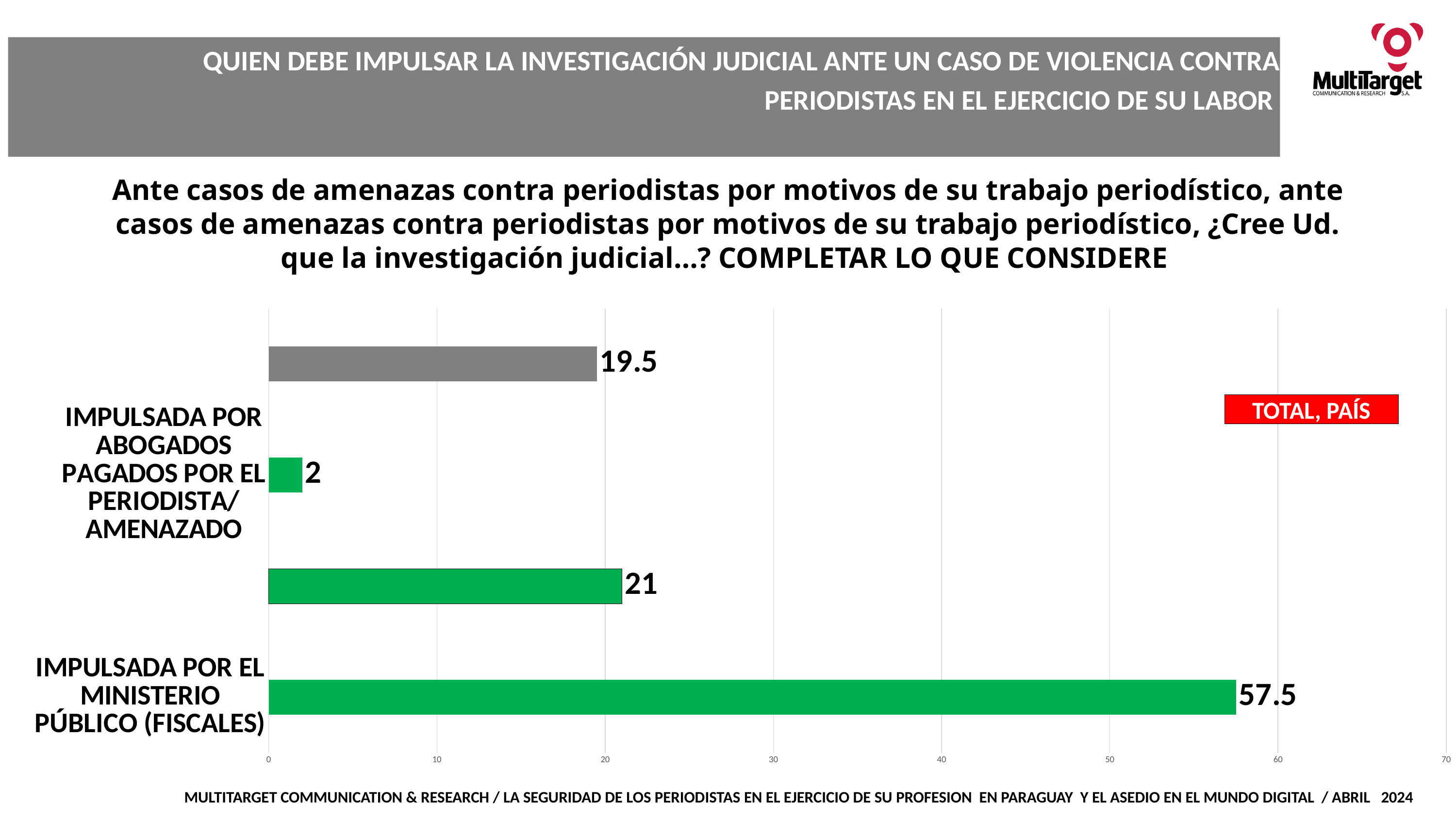
What value is shown for IMPULSADA POR ABOGADOS PAGADOS POR EL PERIODISTA/AMENAZADO? 2 Which category has the lowest value in the chart? IMPULSADA POR ABOGADOS PAGADOS POR EL PERIODISTA/AMENAZADO Which is larger: the value for IMPULSADA POR EL MINISTERIO PÚBLICO (FISCALES) or the value for IMPULSADA POR ABOGADOS PAGADOS POR EL PERIODISTA/AMENAZADO? IMPULSADA POR EL MINISTERIO PÚBLICO (FISCALES) Is the value for IMPULSADA POR EL MINISTERIO PÚBLICO (FISCALES) greater or less than 50? greater What value is shown on the gray bar? 19.5 How many bars are plotted in the chart? 4 What is the difference between the value for IMPULSADA POR EL MINISTERIO PÚBLICO (FISCALES) and the value for IMPULSADA POR ABOGADOS PAGADOS POR EL PERIODISTA/AMENAZADO? 55.5 What kind of chart is shown on the slide? bar chart What text appears in the red legend box on the chart? TOTAL, PAÍS What is the value of the second-longest bar in the chart? 21 Which category has the highest value in the chart? IMPULSADA POR EL MINISTERIO PÚBLICO (FISCALES) What value is shown for IMPULSADA POR EL MINISTERIO PÚBLICO (FISCALES)? 57.5